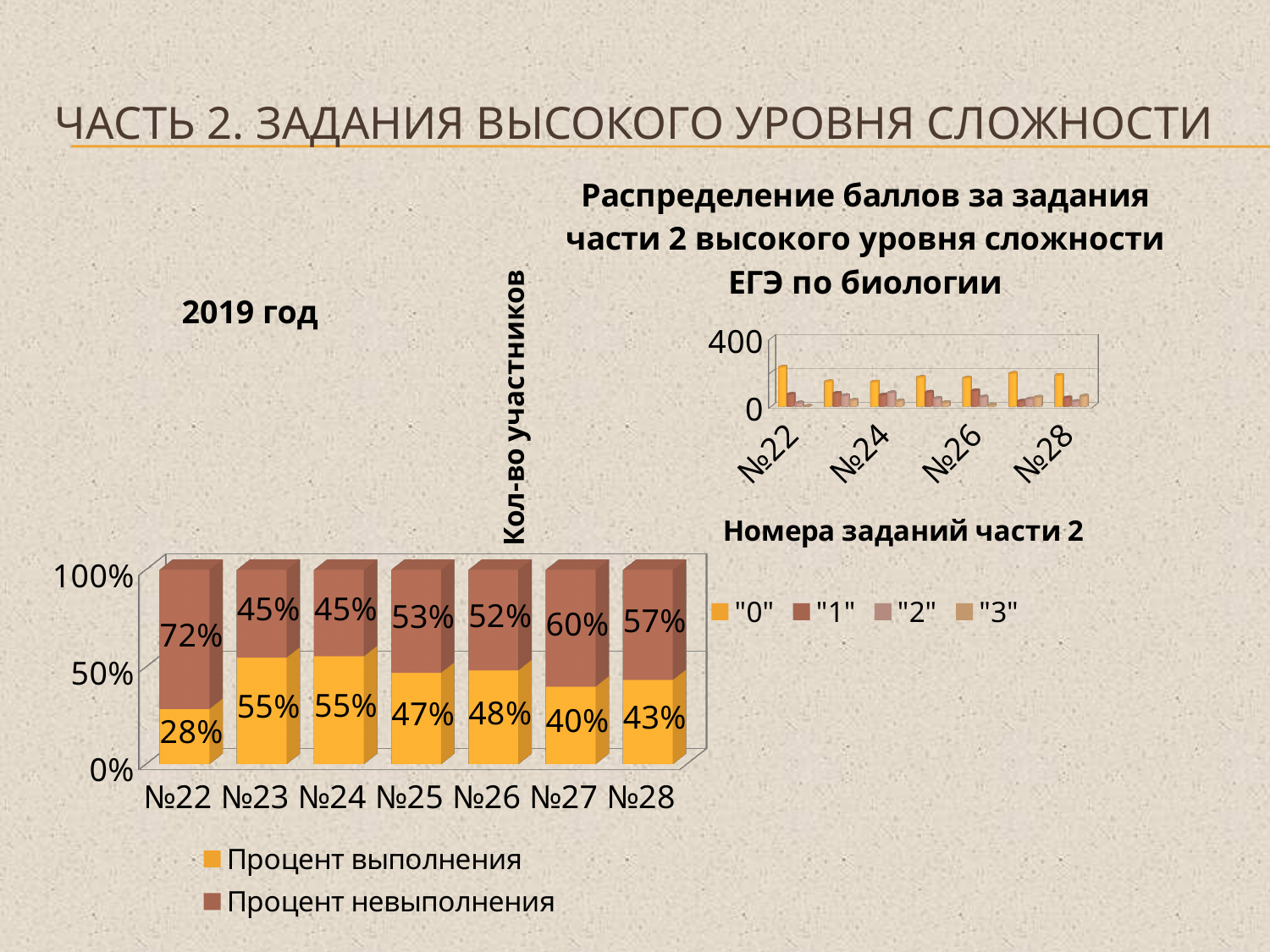
In the '2019 год' chart, which task has the lowest 'Процент выполнения'? №22 In the '2019 год' chart, which task has the highest 'Процент невыполнения'? №22 In the '2019 год' chart, what is the 'Процент выполнения' value for №22? 28% In the 'Распределение баллов за задания части 2 высокого уровня сложности ЕГЭ по биологии' chart, how many series does the legend list? 4 In the '2019 год' chart, what is the difference between the 'Процент невыполнения' and 'Процент выполнения' for №22? 44% In the '2019 год' chart, what is the 'Процент невыполнения' value for №27? 60% In the '2019 год' chart, how many tasks are shown on the x axis? 7 In the '2019 год' chart, how many series does the legend list? 2 In the '2019 год' chart, which is larger for №25: 'Процент выполнения' or 'Процент невыполнения'? Процент невыполнения In the '2019 год' chart, what is the 'Процент выполнения' value for №26? 48% What kind of chart is the '2019 год' chart? Stacked bar chart In the 'Распределение баллов за задания части 2 высокого уровня сложности ЕГЭ по биологии' chart, what is the label of the vertical axis? Кол-во участников